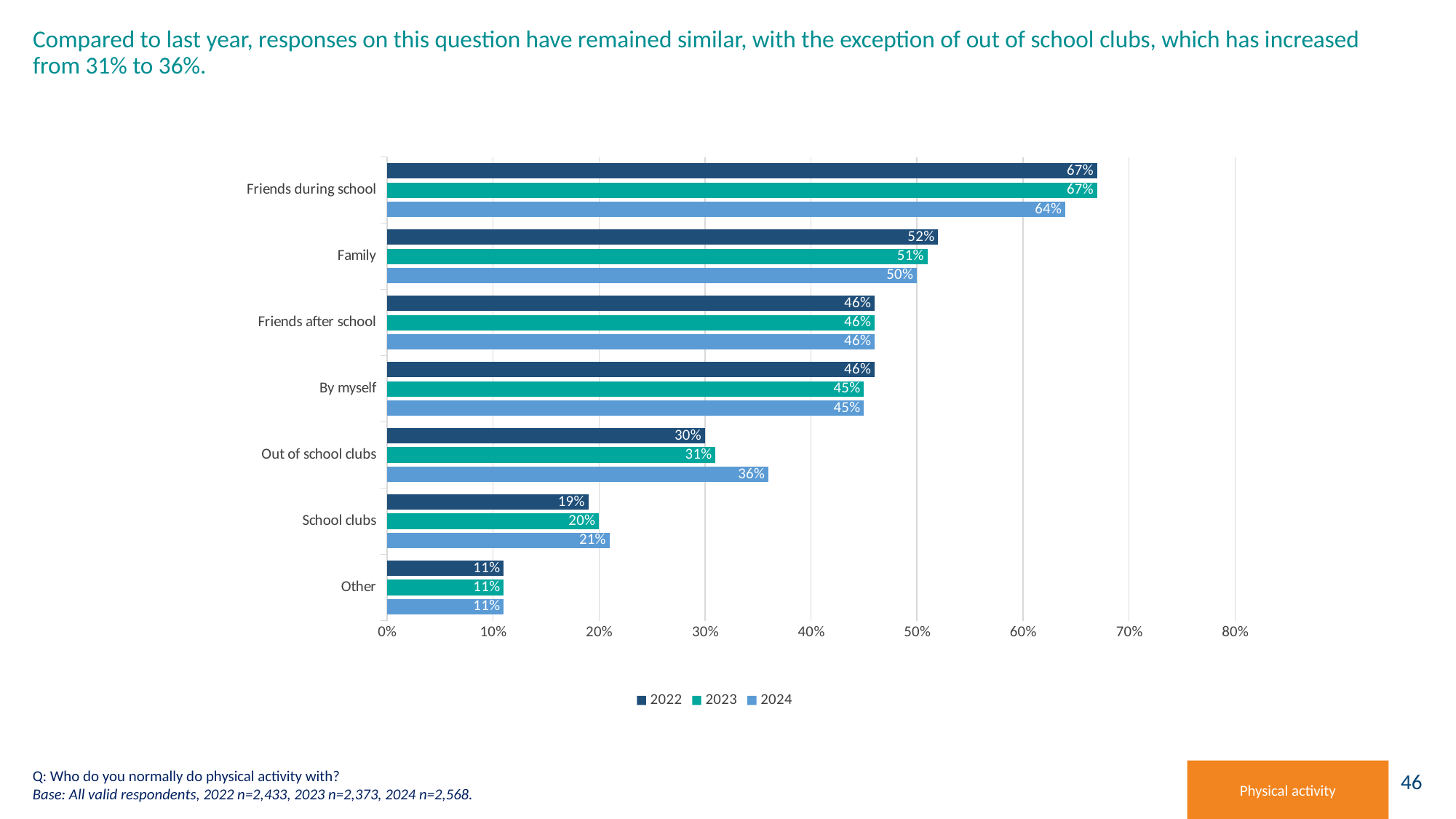
What is the 2023 value for School clubs? 20% What is the difference between the 2024 and 2023 values for Out of school clubs? 5% What is the 2022 value for Family? 52% How many series does the legend list? 3 Which category has the lowest 2022 value? Other Which category has the highest 2024 value? Friends during school What kind of chart is shown on the slide? Bar chart How many categories are shown on the y axis? 7 What are the three series listed in the legend? 2022, 2023, 2024 What is the 2024 value for Out of school clubs? 36% Which is larger for Family: the 2022 value or the 2024 value? 2022 Do the values for Out of school clubs rise or fall from 2022 to 2024? Rise